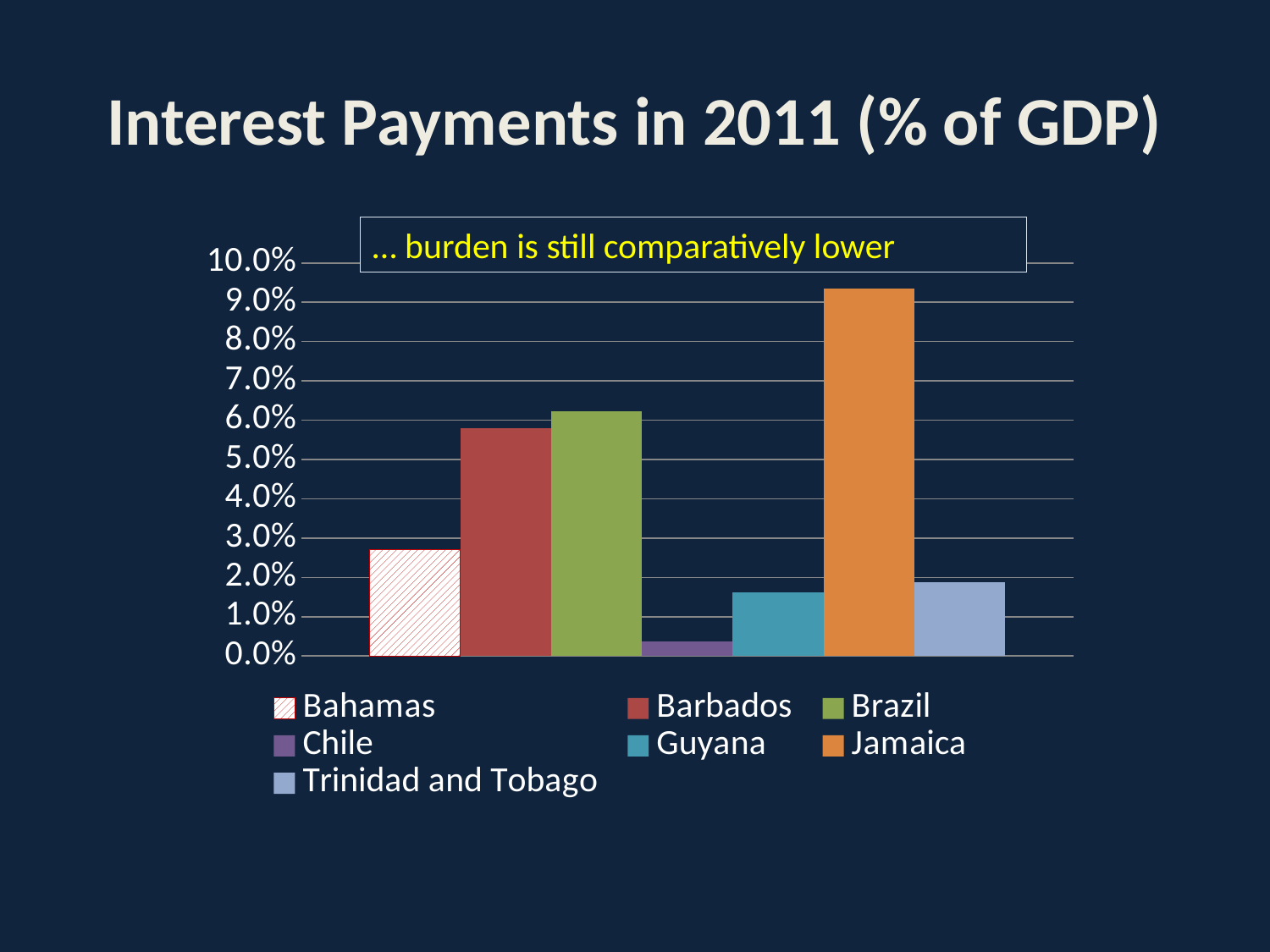
What is the title of the chart? Interest Payments in 2011 (% of GDP) How many countries are listed in the chart legend? 7 What type of chart is shown on the slide? bar chart Which country has the lowest interest payments as a percentage of GDP in 2011? Chile Is the value for Bahamas greater or less than 3.0%? less Is the value for Barbados greater or less than 5.0%? greater Which has a higher value, Jamaica or Brazil? Jamaica Which country has the highest interest payments as a percentage of GDP in 2011? Jamaica Which has a higher value, Barbados or Bahamas? Barbados Is the value for Jamaica greater or less than 9.0%? greater